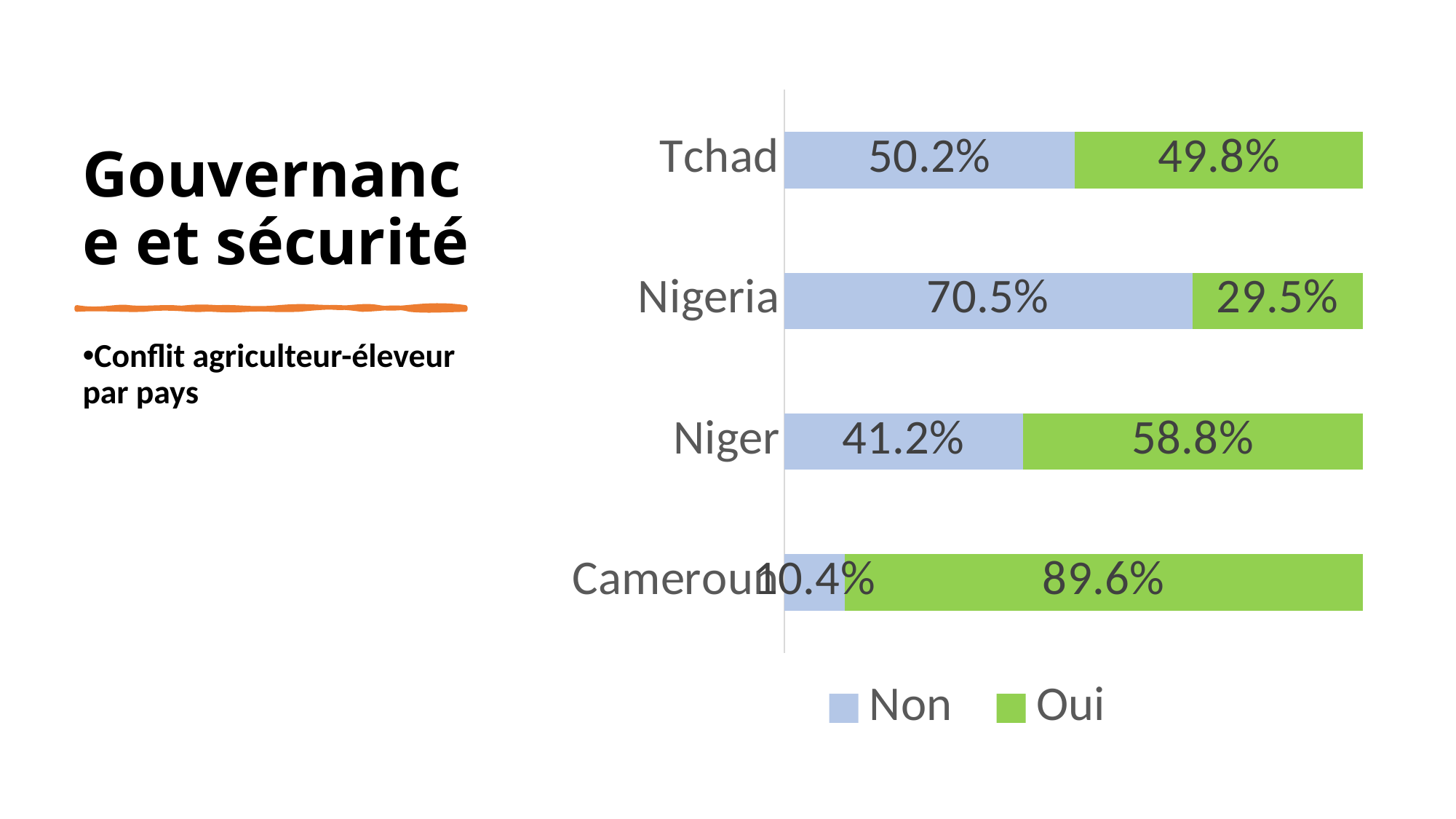
What kind of chart is shown on the slide? Stacked bar chart What is the difference between the 'Oui' and 'Non' values for Niger? 17.6% How many series does the legend list? 2 What is the 'Oui' value for Nigeria? 29.5% Which country has the highest 'Non' value? Nigeria What is the 'Non' value for Niger? 41.2% How many countries are shown in the chart? 4 What is the 'Non' value for Tchad? 50.2% What is the 'Oui' value for Cameroun? 89.6% Which country has the highest 'Oui' value? Cameroun Which country has the lowest 'Non' value? Cameroun Is the 'Oui' value larger for Niger or for Nigeria? Niger